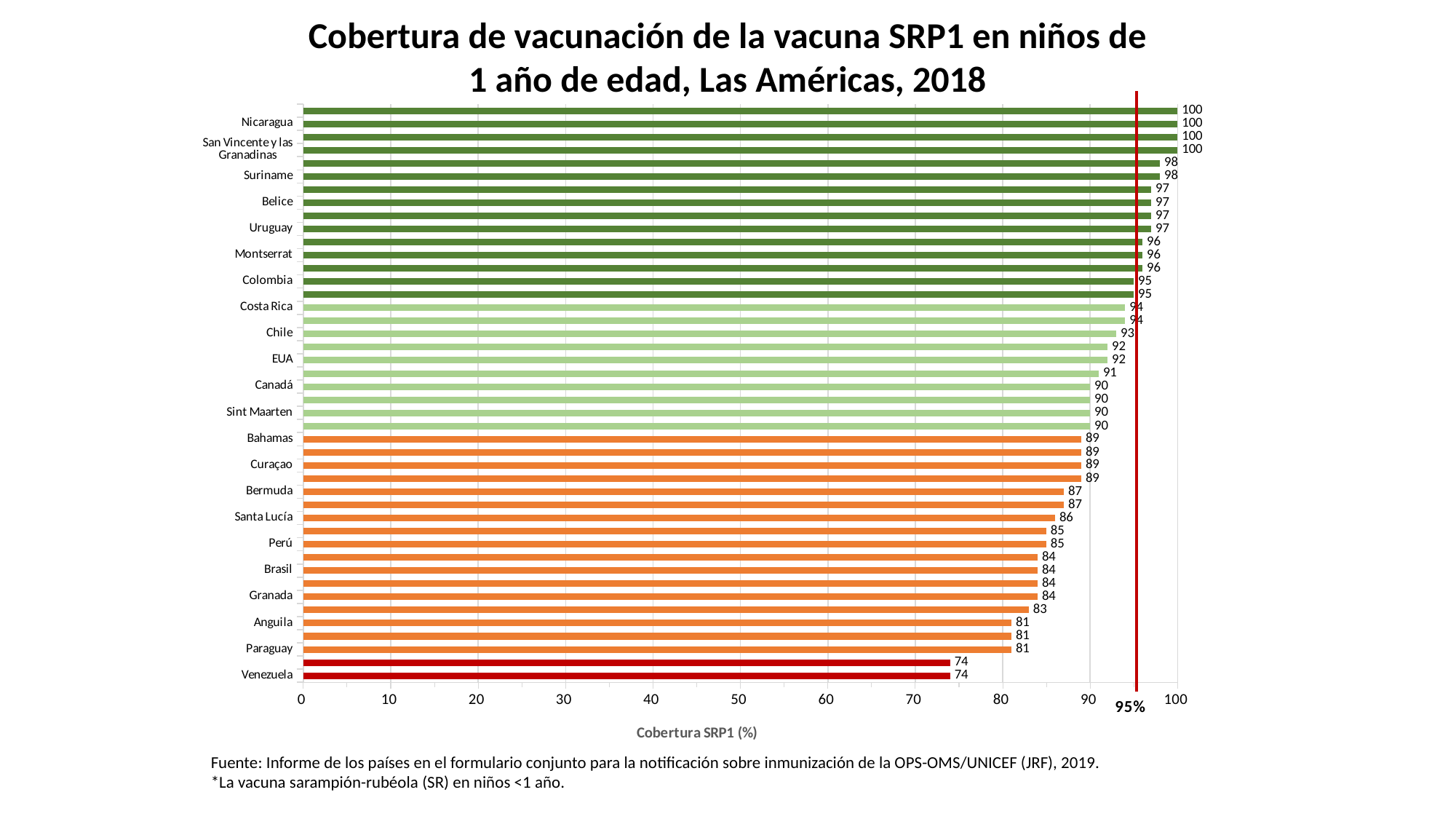
What is the SRP1 coverage value shown for Suriname? 98 What kind of chart is shown on the slide? Bar chart What is the SRP1 coverage value shown for Venezuela? 74 What is the difference between the coverage values for Nicaragua and Venezuela? 26 What is the SRP1 coverage value shown for Perú? 85 Which has a higher SRP1 coverage, Chile or Brasil? Chile Which labelled country has the lowest SRP1 coverage? Venezuela What is the SRP1 coverage value shown for Nicaragua? 100 What is the highest coverage value shown on the chart? 100 What value does the red vertical reference line on the chart mark? 95% Is the value for Paraguay greater or less than 90? less What is the SRP1 coverage value shown for Chile? 93